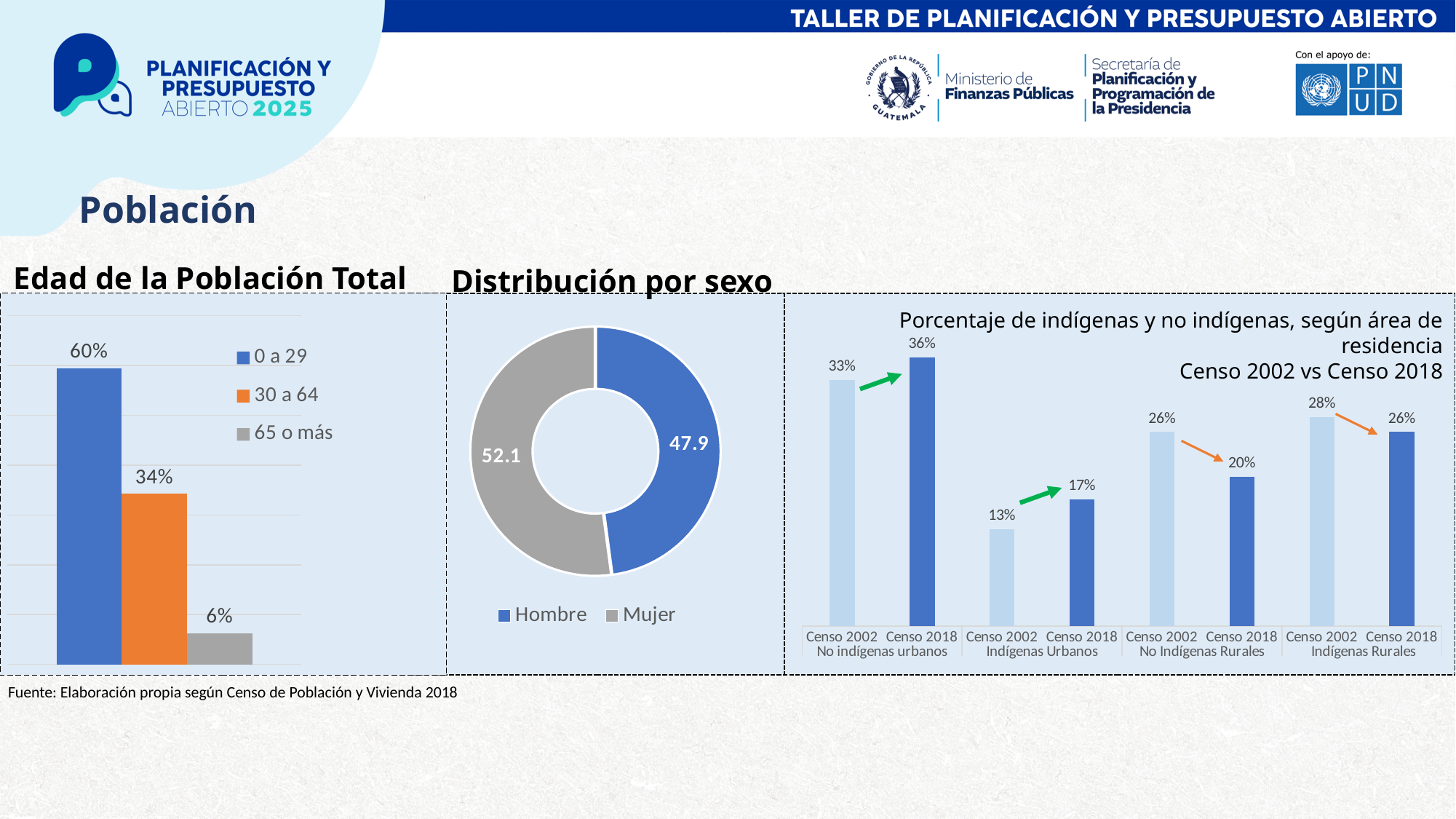
In the 'Distribución por sexo' chart, which is larger, 'Hombre' or 'Mujer'? Mujer In the 'Distribución por sexo' chart, what is the value for 'Mujer'? 52.1 In the 'Edad de la Población Total' chart, what is the value for the '0 a 29' age group? 60% In the 'Edad de la Población Total' chart, what is the difference between the '0 a 29' and '30 a 64' values? 26% In the 'Edad de la Población Total' chart, what is the value for the '65 o más' age group? 6% In the 'Porcentaje de indígenas y no indígenas, según área de residencia' chart, what is the value for 'Censo 2018' in the 'Indígenas Urbanos' group? 17% In the 'Porcentaje de indígenas y no indígenas, según área de residencia' chart, what is the difference between 'Censo 2002' and 'Censo 2018' for 'No Indígenas Rurales'? 6% In the 'Edad de la Población Total' chart, how many series does the legend list? 3 In the 'Porcentaje de indígenas y no indígenas, según área de residencia' chart, which bar has the highest value? Censo 2018, No indígenas urbanos In the 'Edad de la Población Total' chart, which age group has the lowest value? 65 o más In the 'Porcentaje de indígenas y no indígenas, según área de residencia' chart, how many bars are plotted? 8 What kind of chart is the 'Distribución por sexo' chart? Doughnut chart